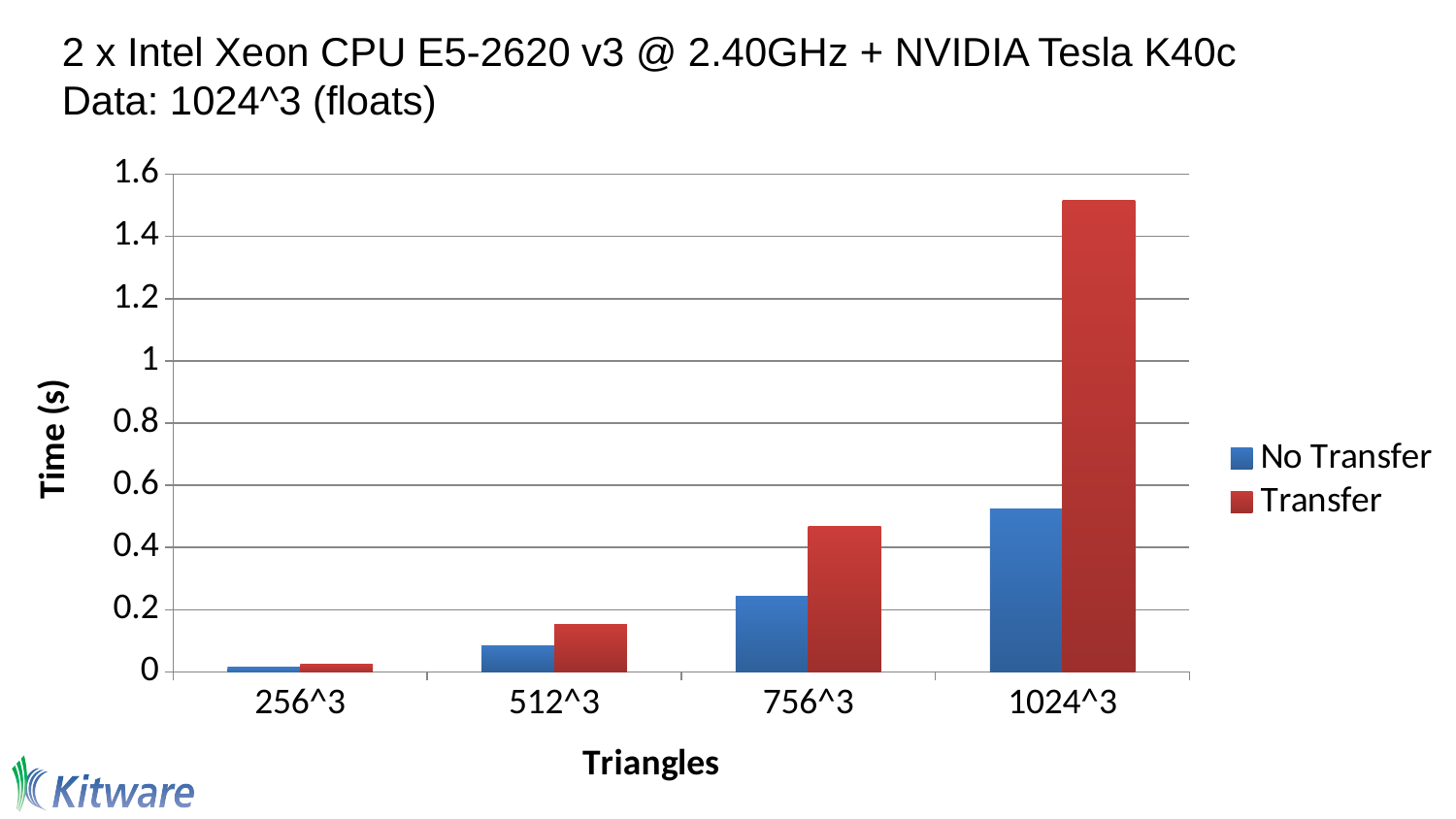
Is the Transfer value for 756^3 greater or less than 0.4? greater For 1024^3, which series has the larger time, No Transfer or Transfer? Transfer Which category has the lowest No Transfer time? 256^3 How many triangle-count categories are shown on the x axis? 4 What kind of chart is shown on the slide? bar chart How many series does the legend list? 2 What is the label of the y axis? Time (s) Which category has the highest Transfer time? 1024^3 Do the Transfer times rise or fall as the number of triangles increases along the x axis? rise Is the No Transfer value for 1024^3 greater or less than 0.6? less Is the Transfer value for 512^3 greater or less than 0.2? less